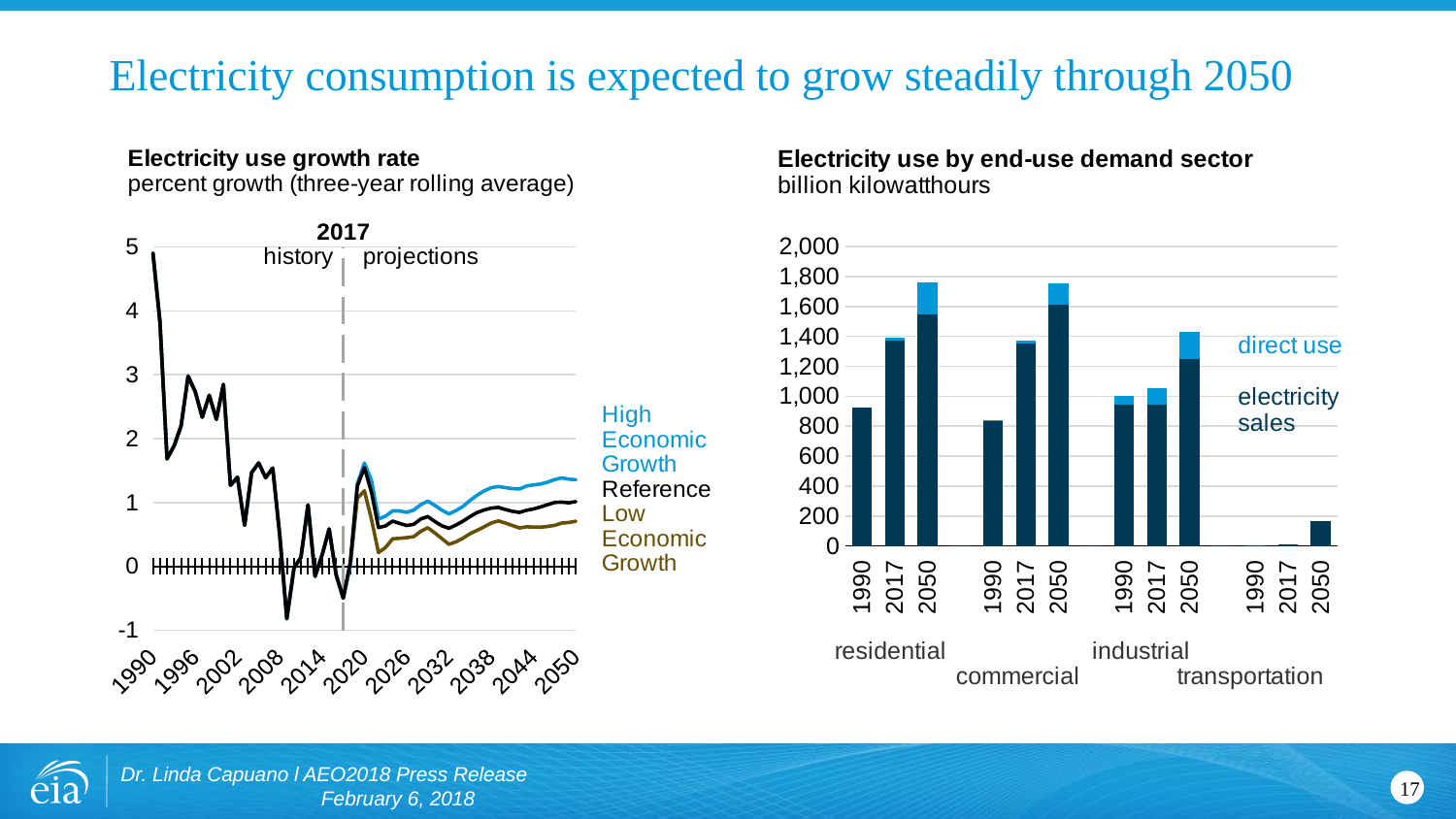
In the 'Electricity use by end-use demand sector' chart, is the total for residential in 2050 greater or less than 1,600? greater What kind of chart is the 'Electricity use by end-use demand sector' chart? bar chart What kind of chart is the 'Electricity use growth rate' chart? line chart In the 'Electricity use growth rate' chart, how many series does the legend list? 3 In the 'Electricity use by end-use demand sector' chart, is the total for transportation in 2017 greater or less than 200? less In the 'Electricity use by end-use demand sector' chart, how many series does the legend list? 2 In the 'Electricity use growth rate' chart, what year marks the boundary between history and projections? 2017 In the 'Electricity use by end-use demand sector' chart, which sector has the lowest total in 2050? transportation In the 'Electricity use by end-use demand sector' chart, is the total for industrial in 1990 greater or less than 1,200? less In the 'Electricity use by end-use demand sector' chart, how many end-use sectors are shown? 4 In the 'Electricity use by end-use demand sector' chart, which is larger in 2050: the residential total or the industrial total? residential In the 'Electricity use growth rate' chart, which series is highest during the projection period? High Economic Growth